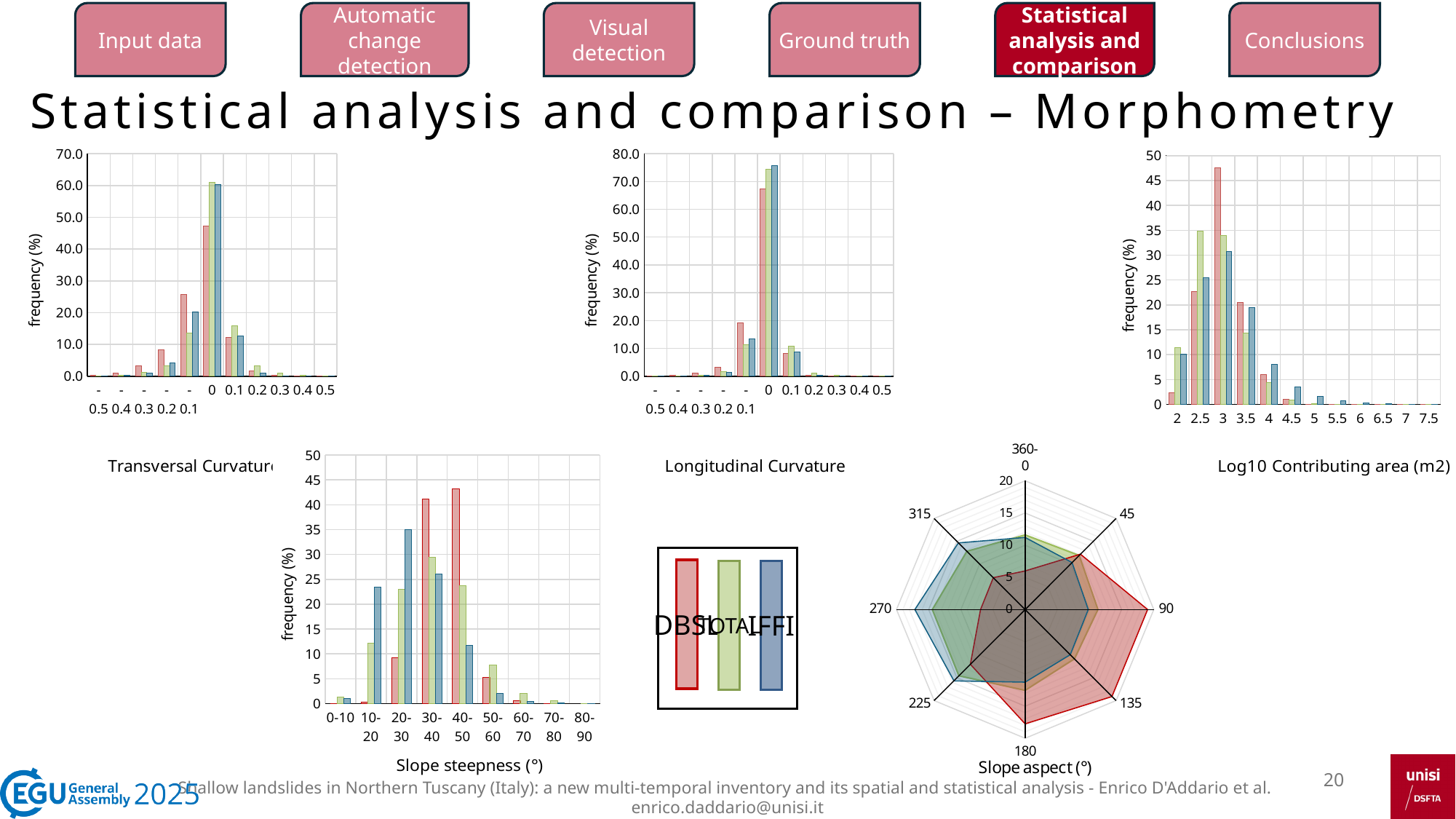
In the Transversal Curvature chart, is the green bar at 0 greater or less than 50.0? greater How many categories are shown on the x axis of the Slope steepness (°) chart? 9 How many series are shown in the legend box in the middle of the slide? 3 How many categories are shown on the x axis of the Transversal Curvature chart? 11 In the Transversal Curvature chart, is the red bar at 0 greater or less than 50.0? less What kind of chart is the Slope steepness (°) chart? bar chart In the Slope steepness (°) chart, is the blue bar for 10-20 greater or less than 20? greater What kind of chart is the Slope aspect chart? radar chart How many categories are shown on the x axis of the Log10 Contributing area (m2) chart? 12 In the Slope steepness (°) chart, which category has the tallest blue bar? 20-30 In the Log10 Contributing area (m2) chart, which category has the tallest red bar? 3